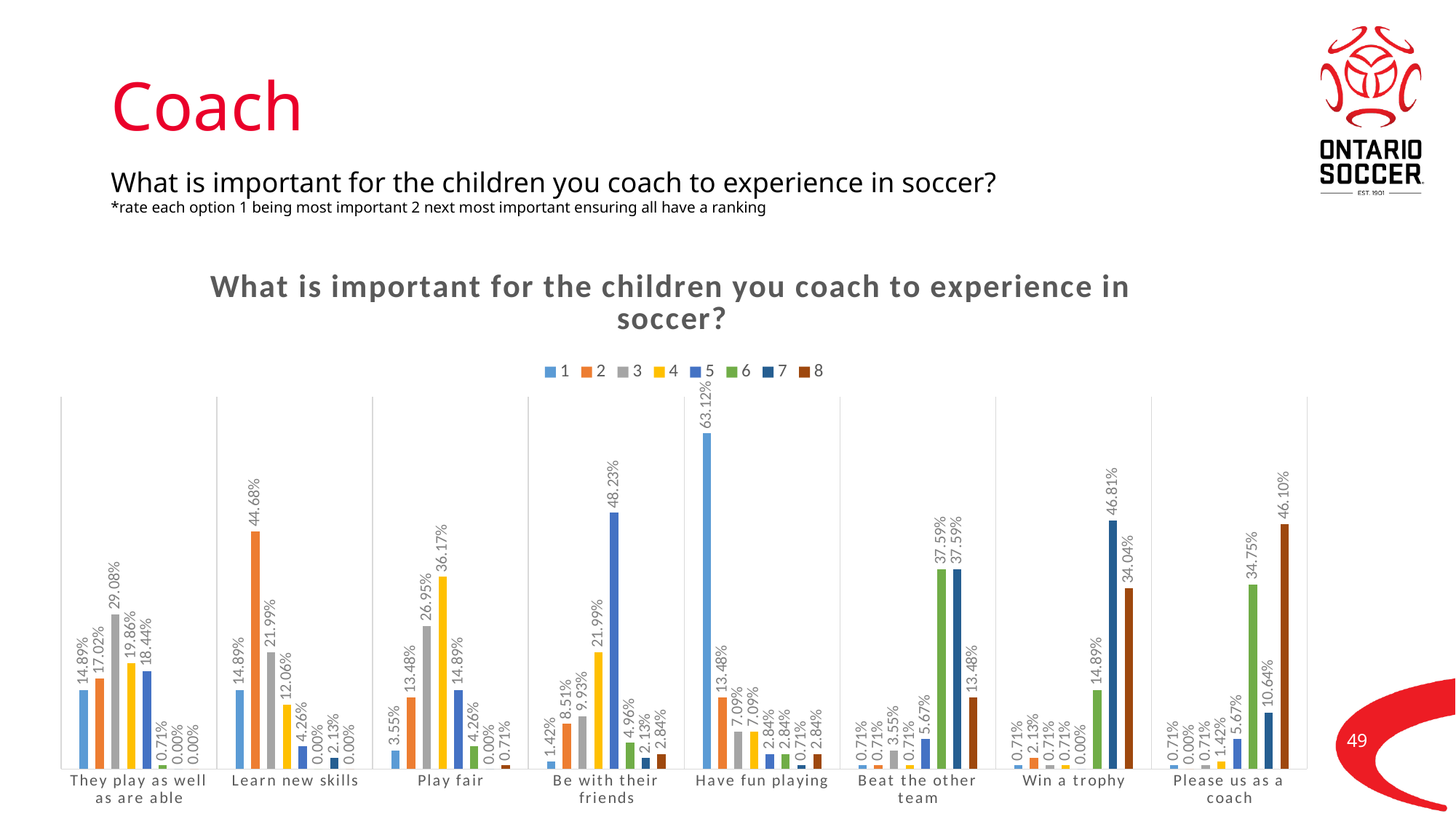
What is the value for series 1 in the 'Have fun playing' category? 63.12% Which category has the highest value for series 7? Win a trophy What is the difference between the series 7 value and the series 8 value in the 'Win a trophy' category? 12.77% How many series does the legend list? 8 Which series has the highest value in the 'Play fair' category? 4 What is the title of the chart? What is important for the children you coach to experience in soccer? What is the value for series 2 in the 'Learn new skills' category? 44.68% What type of chart is shown on the slide? Bar chart Which is larger in the 'They play as well as are able' category: the value for series 3 or the value for series 4? Series 3 How many categories are shown on the x axis? 8 What is the value for series 5 in the 'Be with their friends' category? 48.23% What is the value for series 8 in the 'Please us as a coach' category? 46.10%